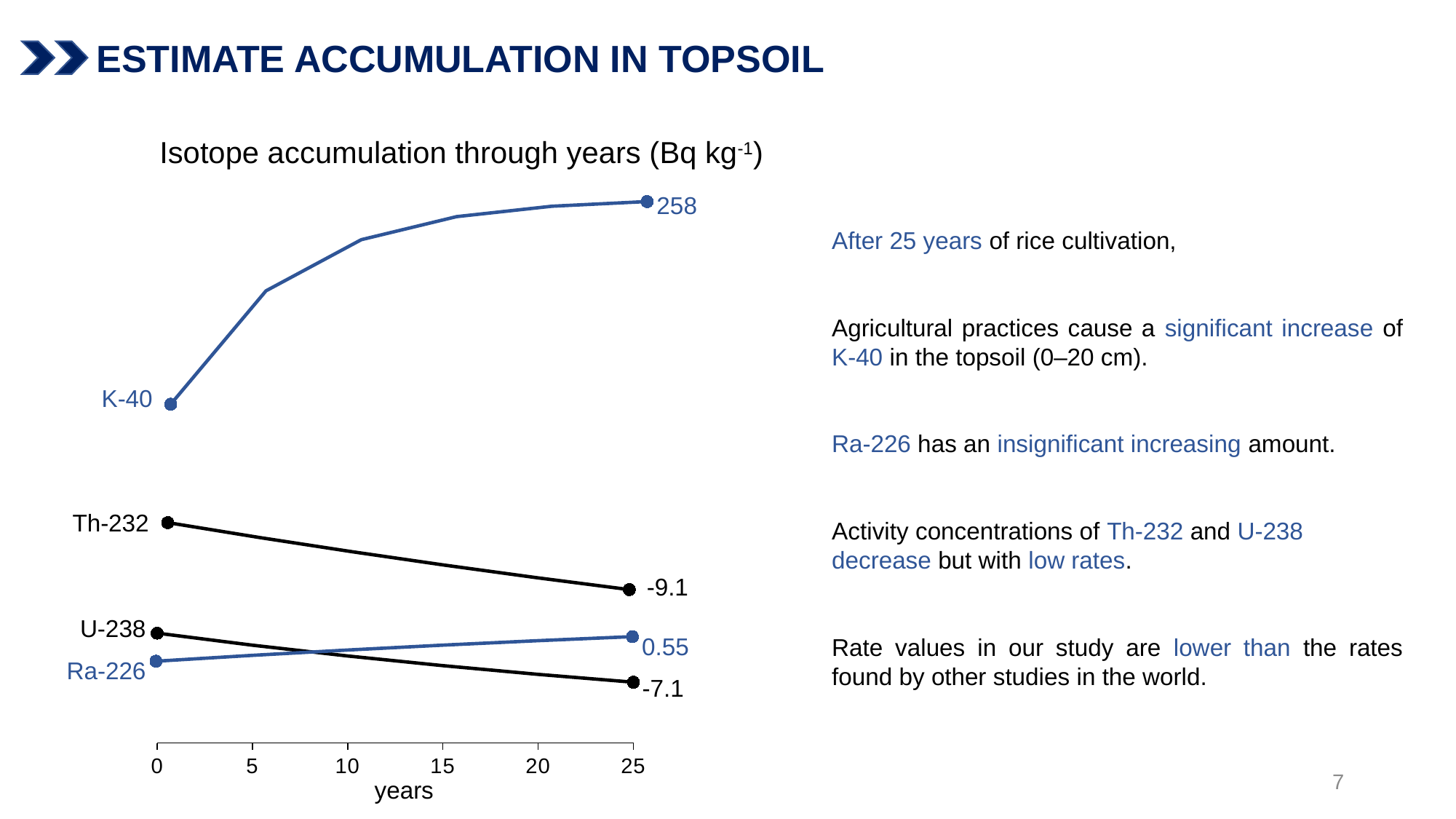
Does the Th-232 line rise or fall from 0 to 25 years? fall What kind of chart is shown on the slide? line chart How many isotopes are plotted on the chart? 4 Does the K-40 line rise or fall from 0 to 25 years? rise